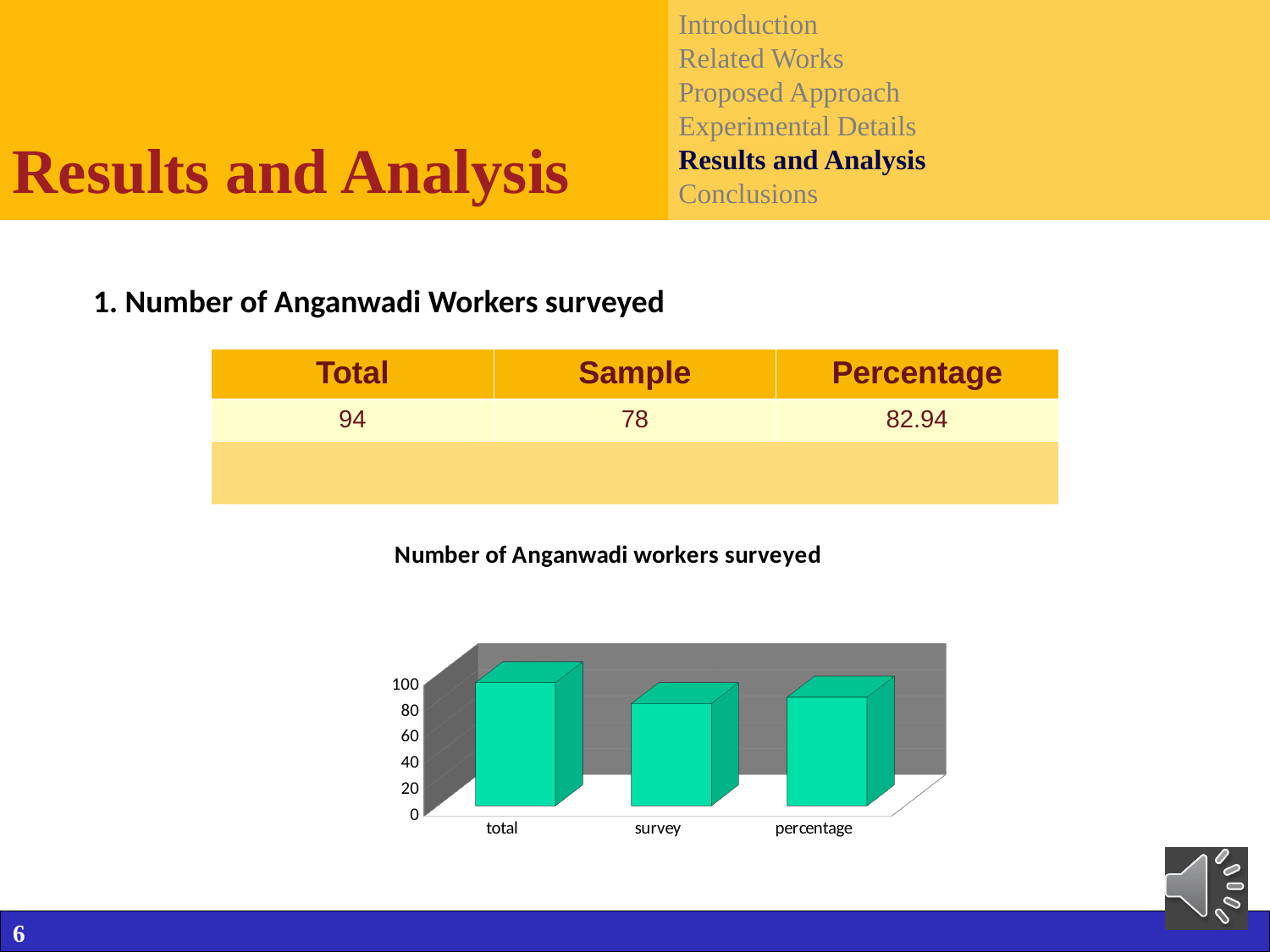
What is the label of the first category on the x axis of the chart? total What is the highest tick value shown on the vertical axis of the chart? 100 Which bar is taller, total or survey? total Is the value for percentage greater or less than 60? greater What kind of chart is shown on the slide? bar chart Is the value for survey greater or less than 60? greater How many categories are plotted on the x axis of the chart? 3 Is the value for survey greater or less than 100? less What is the title of the chart? Number of Anganwadi workers surveyed Which category has the tallest bar in the chart? total